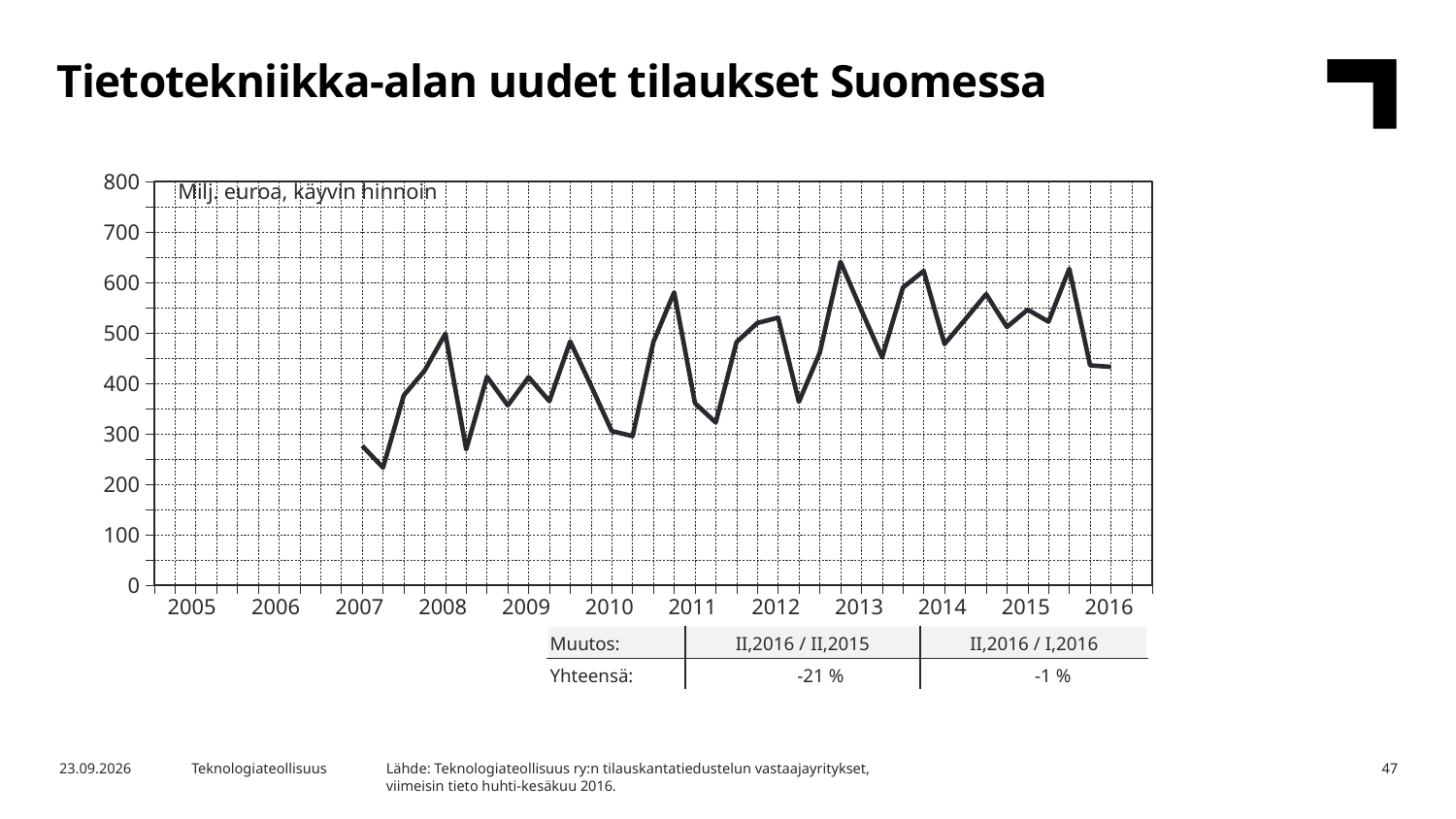
Is the last plotted value in 2016 greater or less than 400? greater What kind of chart is shown on the slide? line chart According to the table below the chart, what is the change for II,2016 / II,2015? -21 % Is the peak value of the line around the start of 2013 greater or less than 600? greater What is the highest value shown on the y axis? 800 Does the line rise or fall between the end of 2015 and 2016? fall What is the title of the chart? Tietotekniikka-alan uudet tilaukset Suomessa According to the table below the chart, what is the change for II,2016 / I,2016? -1 % What unit label is shown inside the chart area? Milj. euroa, käyvin hinnoin Is the last plotted value in 2016 greater or less than 500? less How many year labels are shown on the x axis? 12